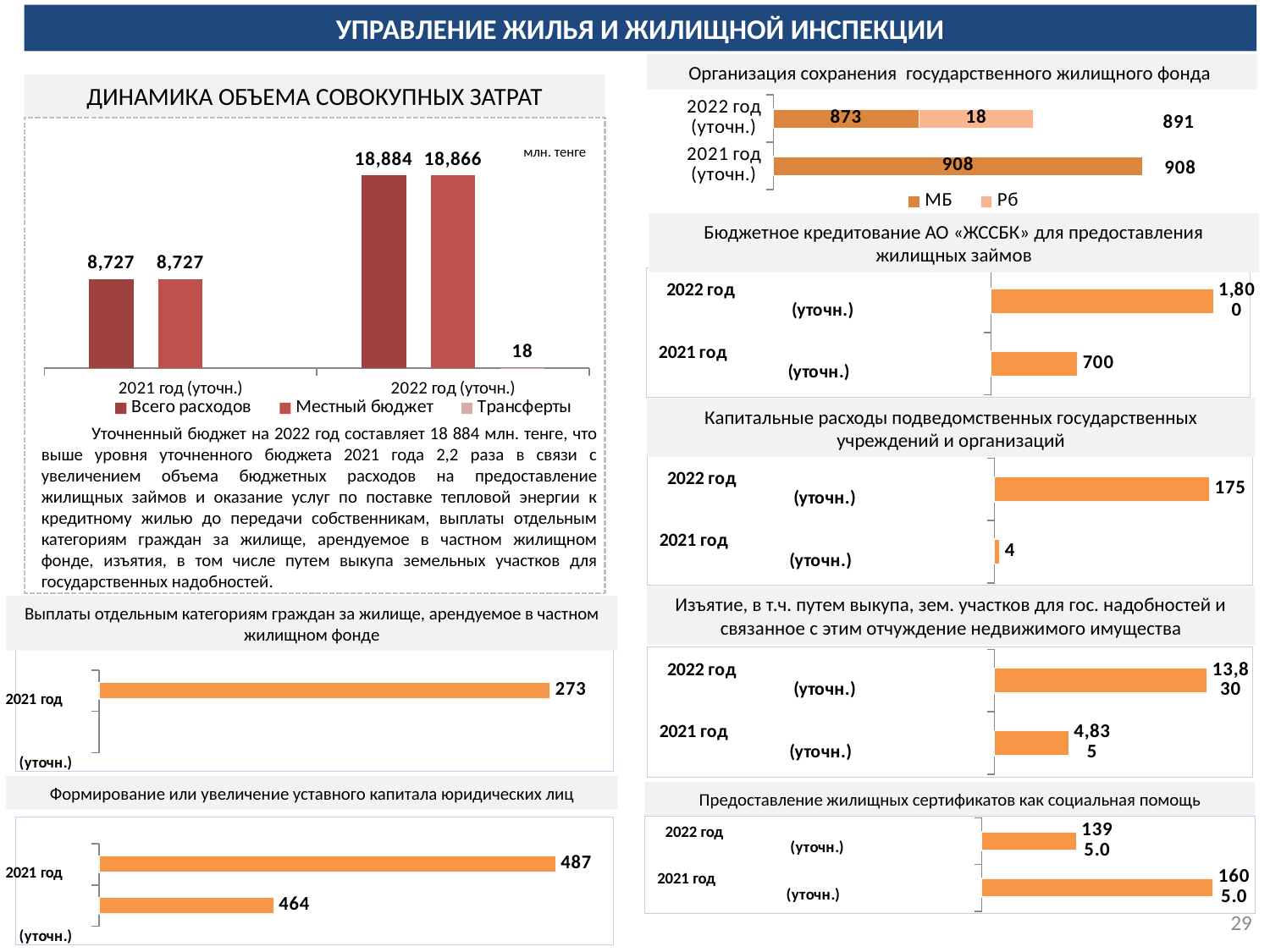
In the chart 'Изъятие, в т.ч. путем выкупа, зем. участков для гос. надобностей и связанное с этим отчуждение недвижимого имущества', what is the value for 2022 год (уточн.)? 13,830 In the chart 'ДИНАМИКА ОБЪЕМА СОВОКУПНЫХ ЗАТРАТ', what is the value of 'Всего расходов' for 2022 год (уточн.)? 18,884 In the chart 'Выплаты отдельным категориям граждан за жилище, арендуемое в частном жилищном фонде', what value is shown for 2021 год? 273 In the chart 'ДИНАМИКА ОБЪЕМА СОВОКУПНЫХ ЗАТРАТ', how many series does the legend list? 3 In the chart 'Организация сохранения государственного жилищного фонда', what is the value of МБ for 2022 год (уточн.)? 873 In the chart 'ДИНАМИКА ОБЪЕМА СОВОКУПНЫХ ЗАТРАТ', what is the difference between 'Всего расходов' in 2022 год (уточн.) and in 2021 год (уточн.)? 10,157 In the chart 'Капитальные расходы подведомственных государственных учреждений и организаций', which year has the higher value? 2022 год (уточн.) In the chart 'Организация сохранения государственного жилищного фонда', what is the total of the stacked bar for 2022 год (уточн.)? 891 In the chart 'ДИНАМИКА ОБЪЕМА СОВОКУПНЫХ ЗАТРАТ', what is the value of 'Трансферты' for 2022 год (уточн.)? 18 In the chart 'Бюджетное кредитование АО «ЖССБК» для предоставления жилищных займов', what is the value for 2021 год (уточн.)? 700 In the chart 'Предоставление жилищных сертификатов как социальная помощь', which year has the longer bar, 2022 год (уточн.) or 2021 год (уточн.)? 2021 год (уточн.) What type of chart is 'Формирование или увеличение уставного капитала юридических лиц'? bar chart